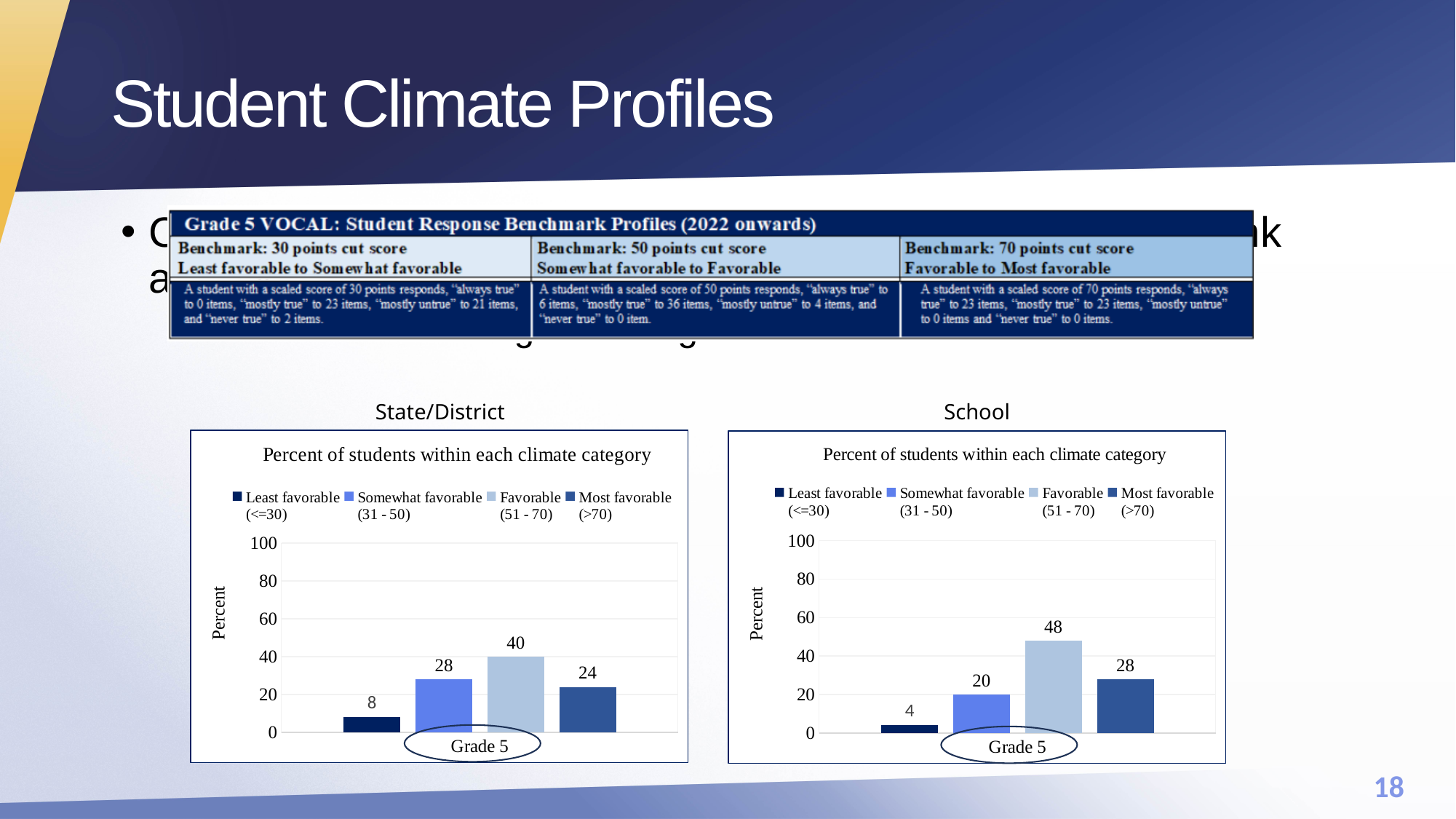
In the School chart, what percent of Grade 5 students are in the Least favorable (<=30) category? 4 How many series does the legend of the State/District chart list? 4 In the State/District chart, what percent of Grade 5 students are in the Favorable (51 - 70) category? 40 In the State/District chart, what is the difference between the Favorable (51 - 70) and Most favorable (>70) percentages? 16 In the School chart, which climate category has the lowest percent of students? Least favorable (<=30) In the School chart, is the value for Favorable (51 - 70) greater or less than 40? greater In the School chart, what percent of Grade 5 students are in the Most favorable (>70) category? 28 In the State/District chart, which climate category has the highest percent of students? Favorable (51 - 70) What is the title of the School chart? Percent of students within each climate category In the School chart, what is the difference between the Favorable (51 - 70) and Somewhat favorable (31 - 50) percentages? 28 What kind of chart is the School chart? Bar chart Which chart shows a larger Somewhat favorable (31 - 50) percentage, State/District or School? State/District